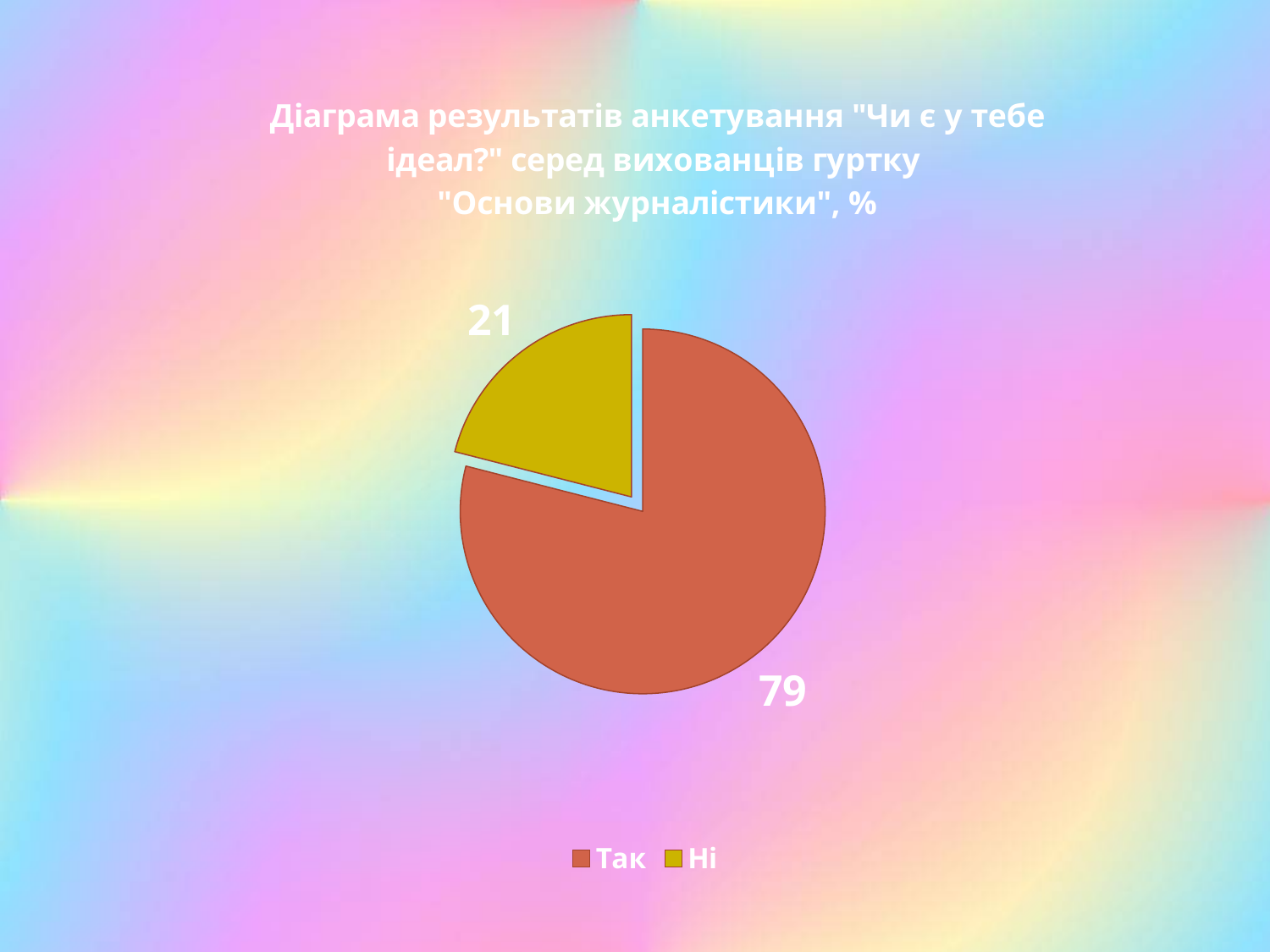
What is the difference between the values for "Так" and "Ні"? 58 Which legend entry is shown in yellow? Ні Which is larger, the value for "Так" or the value for "Ні"? Так How many entries does the legend list? 2 What type of chart is shown on the slide? pie chart What colour is the "Так" slice? red Which category has the smallest slice? Ні What is the value for "Ні"? 21 What share of the pie does the "Ні" slice represent? 21% How many slices does the pie chart have? 2 Which category has the largest slice? Так What is the value for "Так"? 79